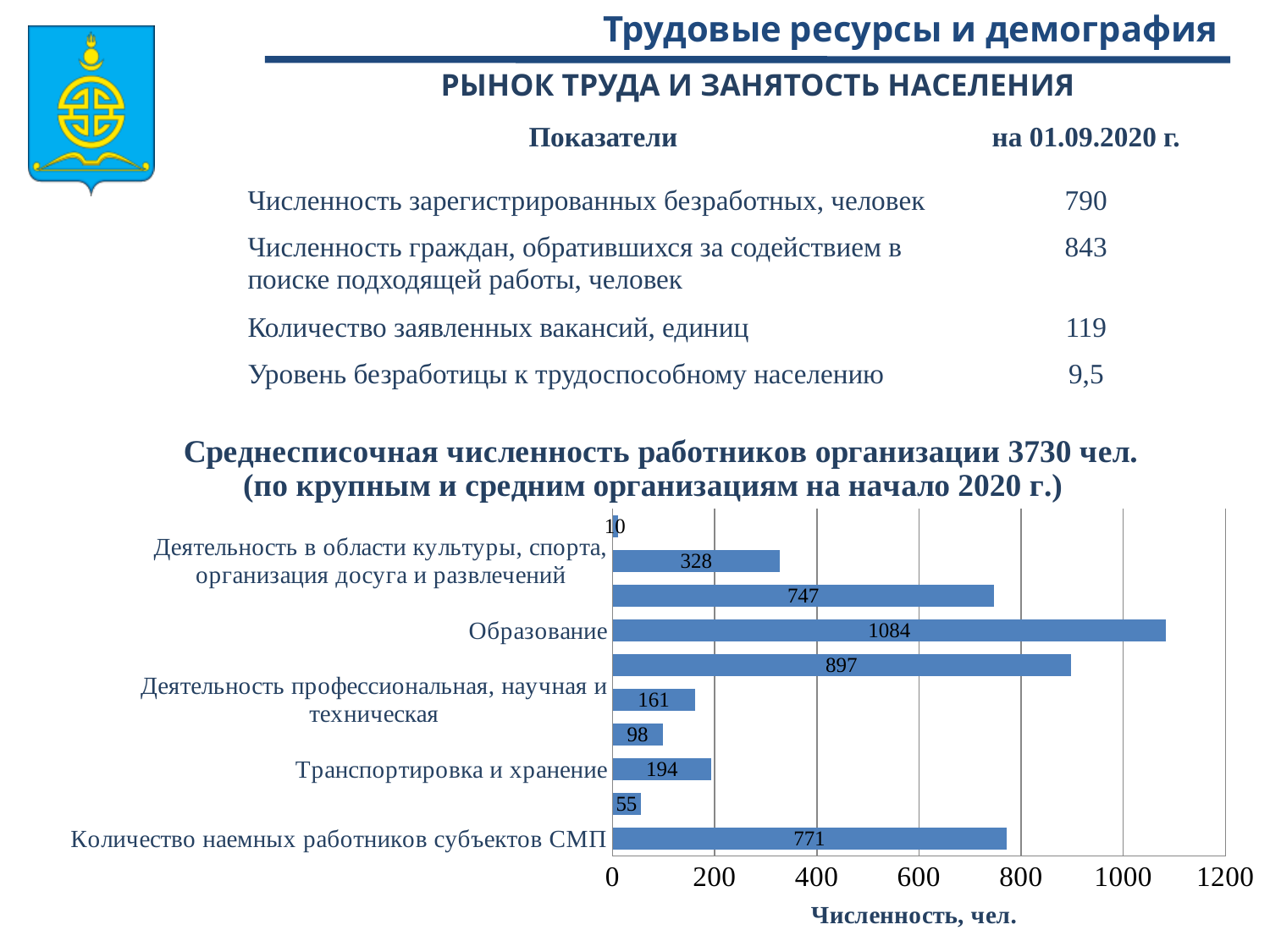
What type of chart is shown on the slide? bar chart How many bars are plotted in the chart? 10 Which is larger: the value for Транспортировка и хранение or the value for Деятельность профессиональная, научная и техническая? Транспортировка и хранение What is the value for Транспортировка и хранение? 194 What is the value for Деятельность профессиональная, научная и техническая? 161 What is the smallest value shown on any bar in the chart? 10 Which labelled category has the highest value in the chart? Образование What is the difference between the values for Образование and Количество наемных работников субъектов СМП? 313 What is the value for Образование in the chart? 1084 What is the value for Деятельность в области культуры, спорта, организация досуга и развлечений? 328 What is the value for Количество наемных работников субъектов СМП? 771 What is the title of the horizontal axis of the chart? Численность, чел.